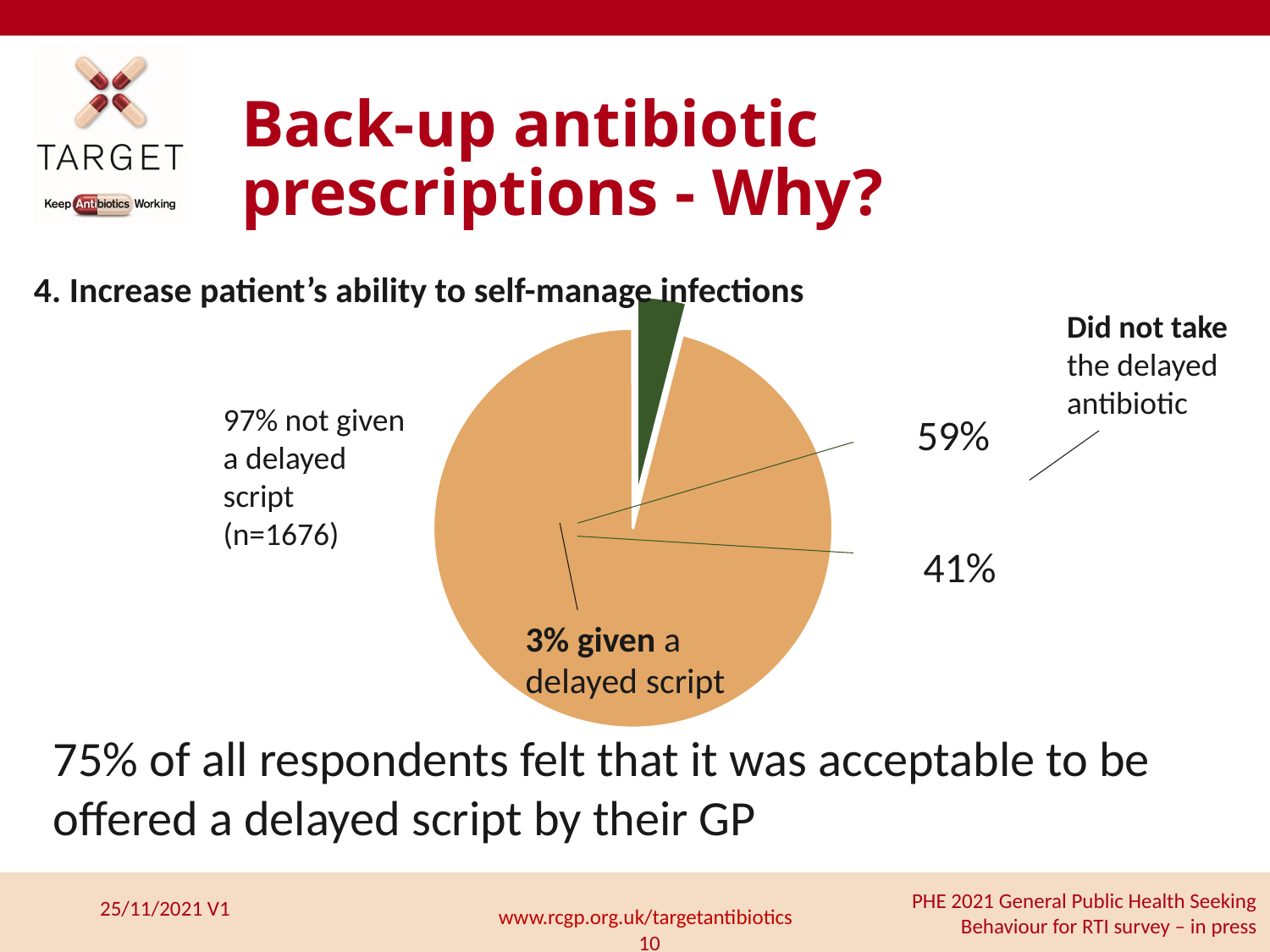
Which is larger: the share not given a delayed script or the share given a delayed script? not given a delayed script Which slice of the pie chart is the largest? 97% not given a delayed script What is the difference in percentage points between the 'not given a delayed script' slice and the 'given a delayed script' slice? 94 percentage points What colour is the small slice representing those given a delayed script? dark green What is the other percentage shown next to the 59% label for the delayed-script group? 41% What share of respondents were not given a delayed script? 97% What kind of chart is shown on the slide? pie chart Which slice of the pie chart is the smallest? 3% given a delayed script What is the sample size (n) shown for those not given a delayed script? n=1676 What share of respondents were given a delayed script? 3% How many slices does the pie chart have? 2 Of those given a delayed script, what percentage did not take the delayed antibiotic? 59%